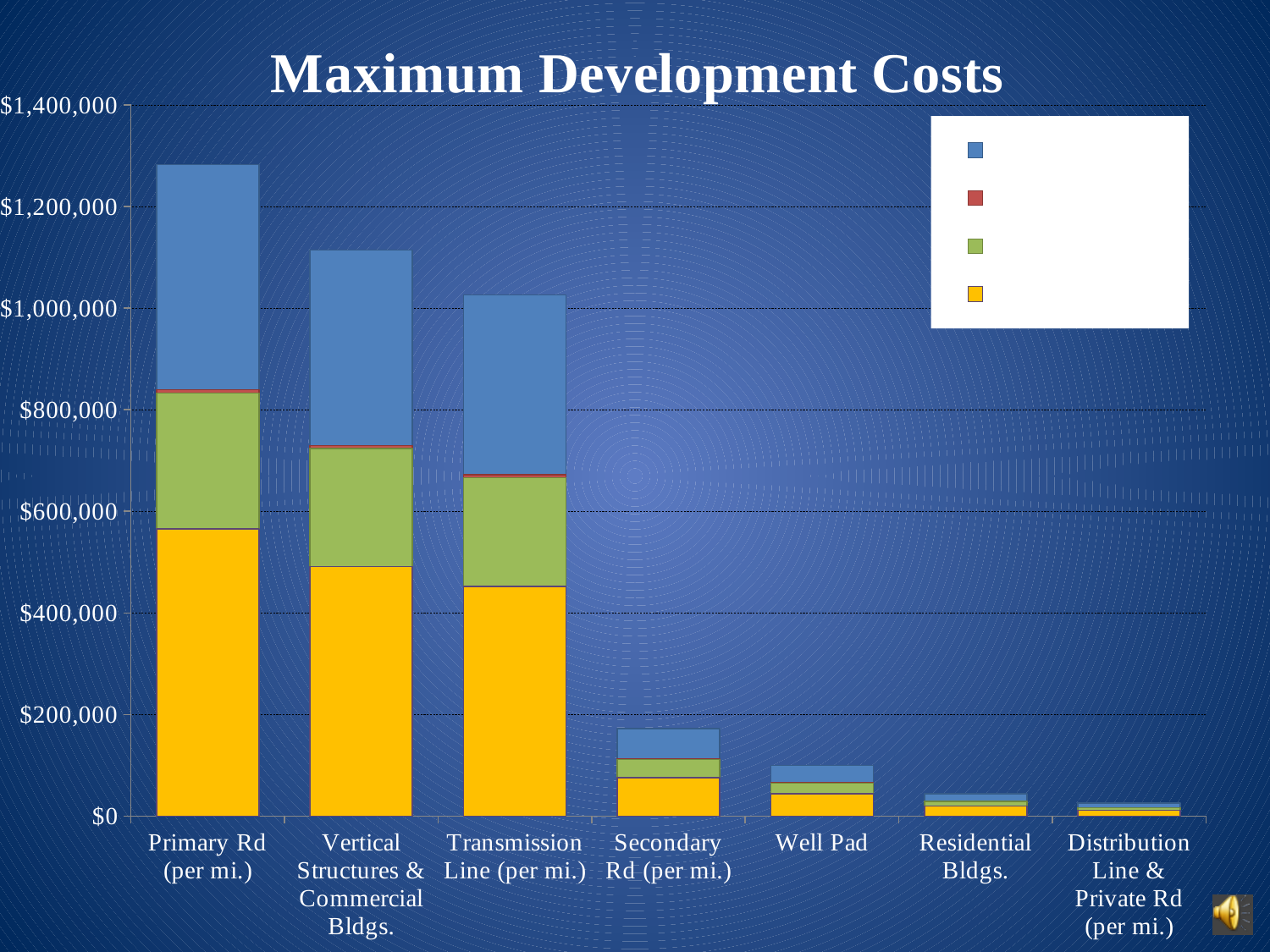
Is the total value for Primary Rd (per mi.) greater or less than $1,200,000? greater Is the total value for Transmission Line (per mi.) greater or less than $1,200,000? less Which category has the highest total maximum development cost? Primary Rd (per mi.) Which category has the lowest total maximum development cost? Distribution Line & Private Rd (per mi.) What kind of chart is shown on the slide? Bar chart Which has the larger total: Vertical Structures & Commercial Bldgs. or Transmission Line (per mi.)? Vertical Structures & Commercial Bldgs. What is the title of the chart? Maximum Development Costs Is the total value for Secondary Rd (per mi.) greater or less than $200,000? less How many categories are shown along the x axis? 7 Do the bar totals rise or fall moving from left to right along the x axis? fall How many series does the legend list? 4 Which has the larger total: Secondary Rd (per mi.) or Well Pad? Secondary Rd (per mi.)